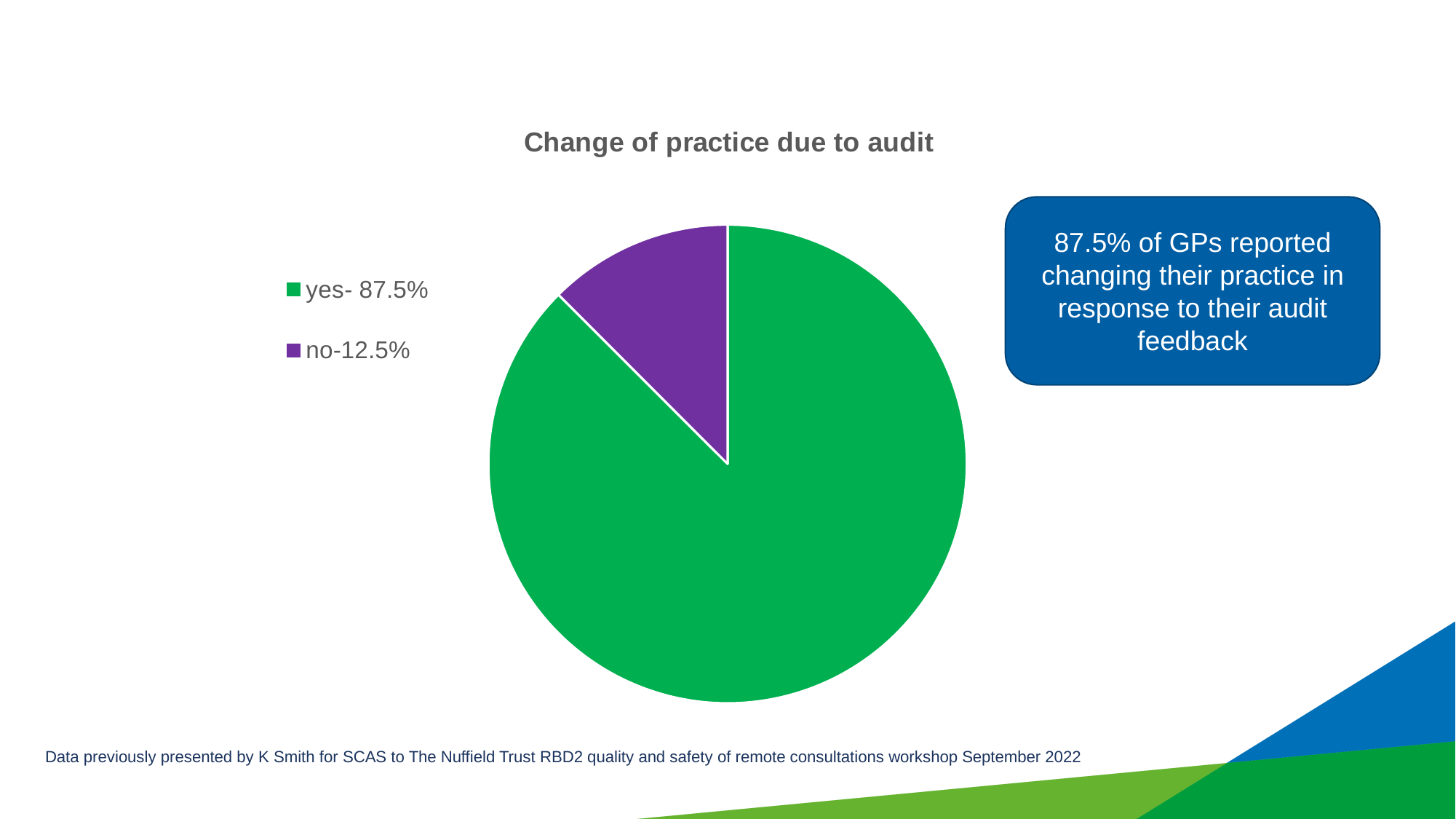
What is the title of the chart? Change of practice due to audit How many slices does the pie chart have? 2 Which is larger, the 'yes' slice or the 'no' slice? yes Which slice is the smallest in the pie chart? no What is the difference in percentage points between the 'yes' and 'no' slices? 75 How many entries does the legend list? 2 What kind of chart is shown on the slide? pie chart What share of the pie is the 'no' slice? 12.5% What colour is the 'no' slice in the pie chart? purple Which slice is the largest in the pie chart? yes What share of the pie is the 'yes' slice? 87.5%